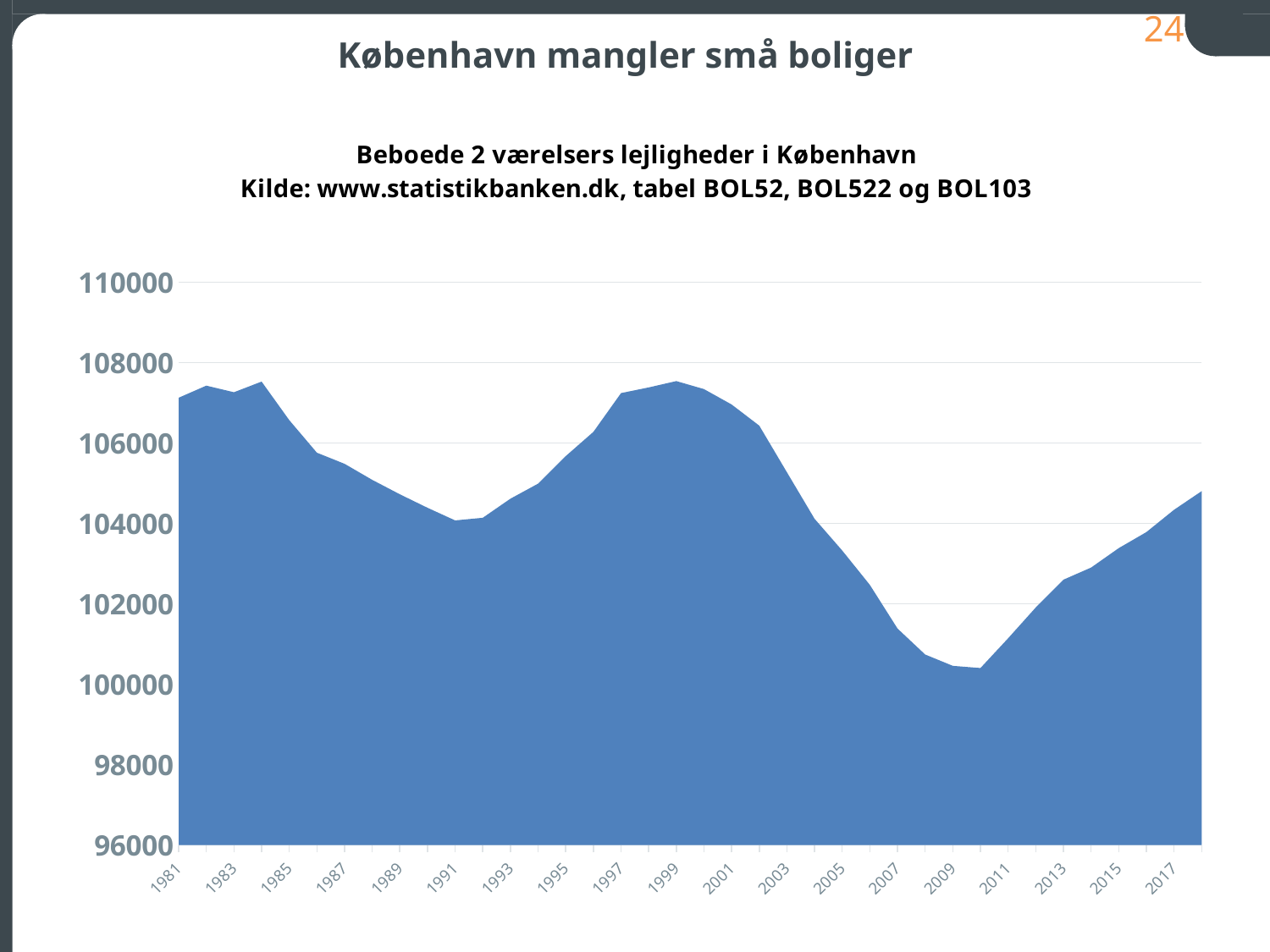
Is the value for 2017 greater or less than 106000? less How many year labels are shown on the x axis? 19 Around which year does the chart reach its highest value? 1999 Is the value for 2009 greater or less than 102000? less What kind of chart is shown on the slide? area chart Is the value for 1991 greater or less than 106000? less Which year has the larger value, 1999 or 2009? 1999 What is the title of the chart? Beboede 2 værelsers lejligheder i København Around which year does the chart reach its lowest value? 2010 Do the values rise or fall between 1999 and 2009? fall